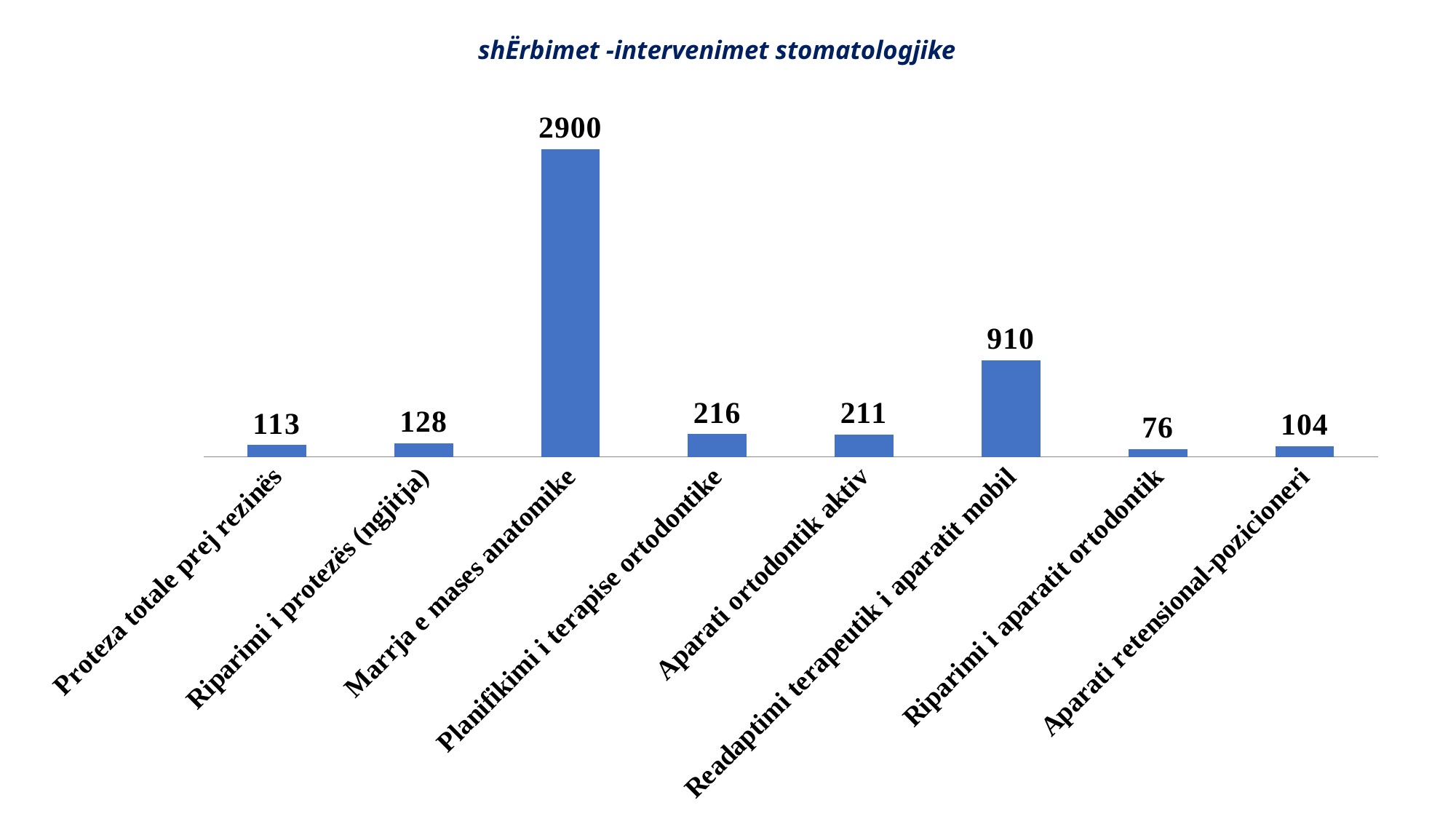
What is the value for Riparimi i aparatit ortodontik? 76 What kind of chart is shown on the slide? Bar chart Which is larger, the value for Planifikimi i terapise ortodontike or the value for Aparati ortodontik aktiv? Planifikimi i terapise ortodontike What is the value for Readaptimi terapeutik i aparatit mobil? 910 What is the difference between the values for Marrja e mases anatomike and Readaptimi terapeutik i aparatit mobil? 1990 Which category has the lowest value? Riparimi i aparatit ortodontik What is the difference between the values for Riparimi i protezës (ngjitja) and Proteza totale prej rezinës? 15 How many categories are shown in the chart? 8 What is the value for Marrja e mases anatomike? 2900 What is the title of the chart? shËrbimet -intervenimet stomatologjike Which category has the highest value? Marrja e mases anatomike What is the value for Aparati retensional-pozicioneri? 104